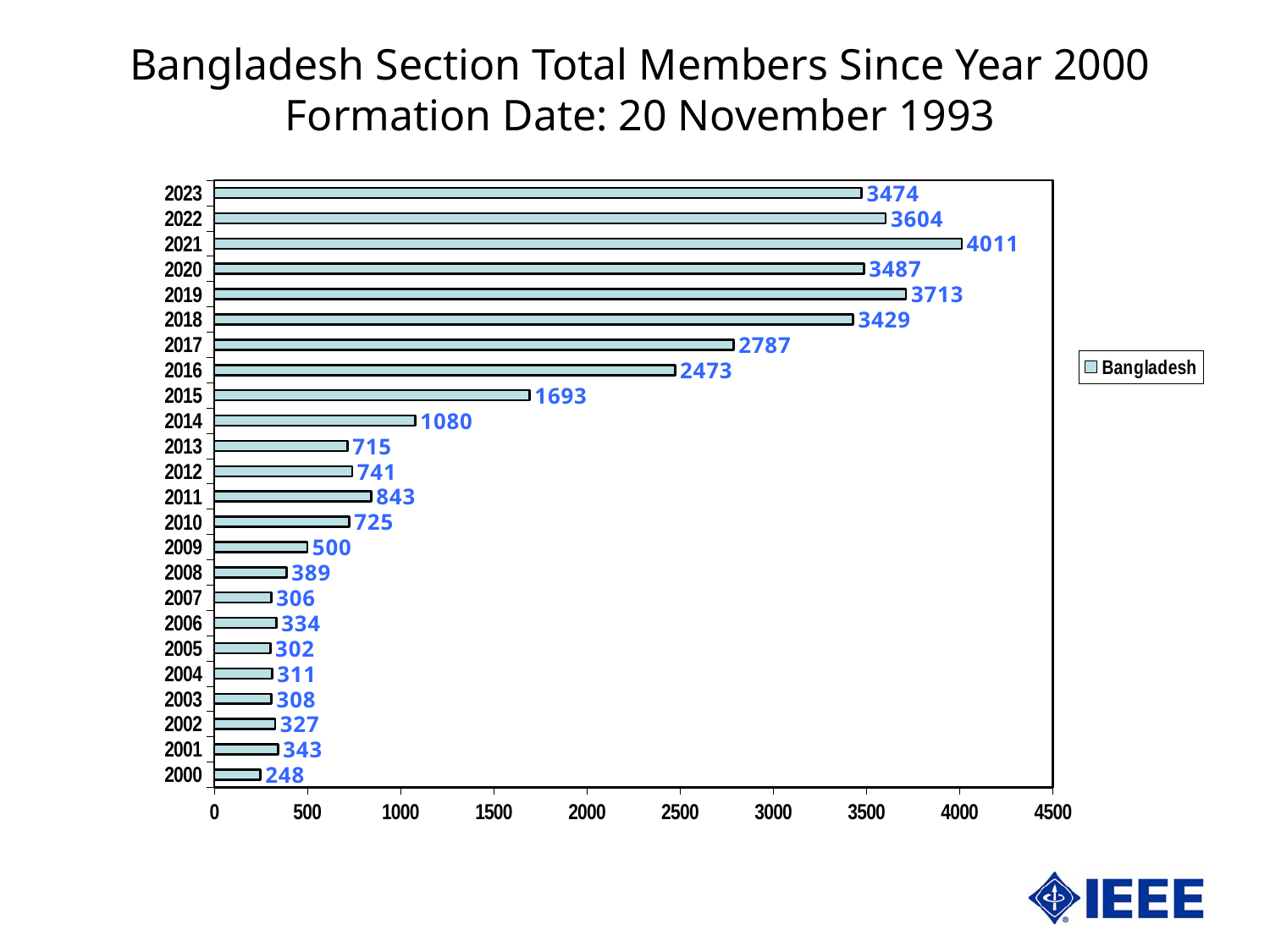
What is the name of the series shown in the legend? Bangladesh Which year has the lowest number of members? 2000 What is the total number of members for 2021? 4011 How many years are shown on the chart? 24 What is the total number of members for 2015? 1693 Which year has the highest number of members? 2021 How many series does the legend list? 1 Which year has more members, 2019 or 2020? 2019 What kind of chart is shown on the slide? bar chart What is the total number of members for 2000? 248 What is the difference in members between 2022 and 2023? 130 Is the value for 2017 greater or less than 2500? greater